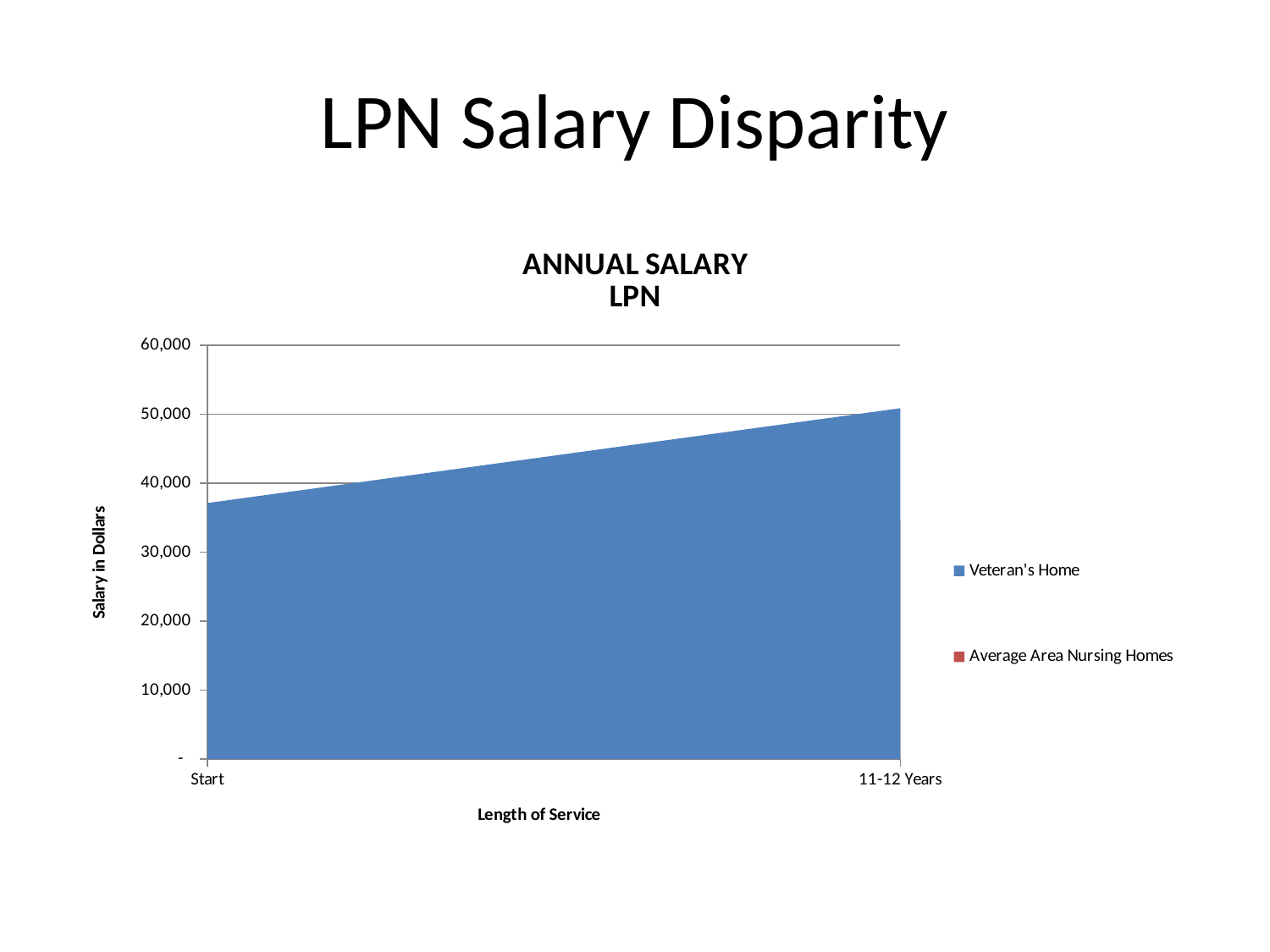
Which category has the lowest Veteran's Home salary? Start How many categories are shown on the x axis of the chart? 2 Does the Veteran's Home salary rise or fall from Start to 11-12 Years? Rise Is the Veteran's Home value at 11-12 Years greater or less than 40,000? greater What is the label of the y axis of the chart? Salary in Dollars Is the Veteran's Home value at 11-12 Years greater or less than 60,000? less Which category has the higher Veteran's Home salary, Start or 11-12 Years? 11-12 Years Is the Veteran's Home value at Start greater or less than 30,000? greater What kind of chart is shown on the slide? Area chart What is the title of the chart? ANNUAL SALARY LPN How many series does the chart legend list? 2